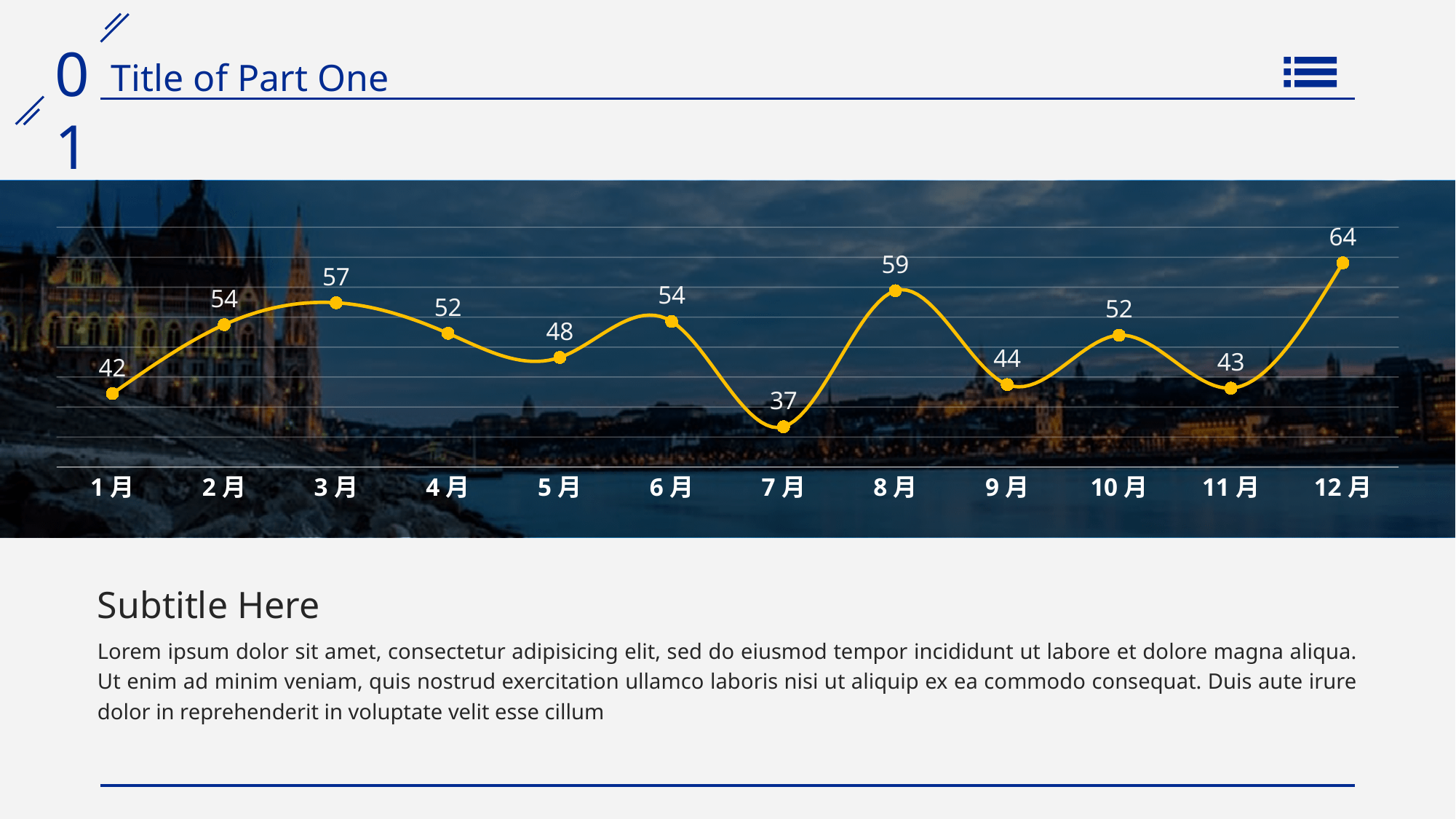
Which is larger, the value for 2月 or the value for 11月? 2月 What colour is the line on the chart? yellow What is the value for 7月? 37 Which month has the highest value? 12月 What is the value for 3月? 57 What is the value for 10月? 52 What is the difference between the values for 8月 and 9月? 15 Which month has the lowest value? 7月 Do the values rise or fall from 9月 to 10月? rise What is the difference between the values for 12月 and 1月? 22 How many months are plotted on the chart? 12 What kind of chart is shown on the slide? line chart